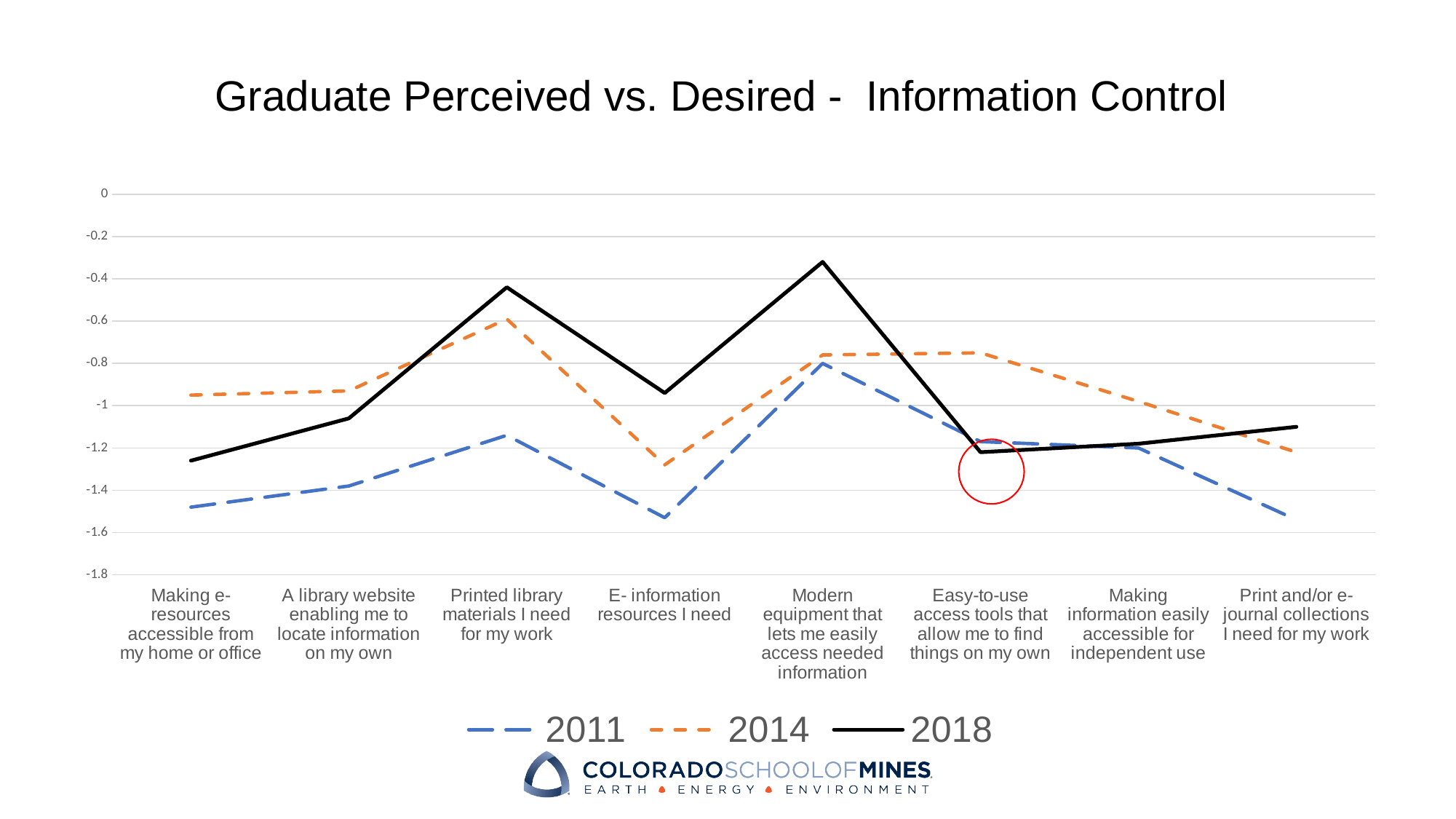
How many categories are plotted along the x axis? 8 For 'E- information resources I need', which series has the higher value, 2018 or 2014? 2018 Which series is drawn as a solid black line? 2018 Is the 2014 value for 'Printed library materials I need for my work' greater or less than -0.8? greater For the 2018 series, which category has the highest value? Modern equipment that lets me easily access needed information How many series does the legend list? 3 What kind of chart is shown on the slide? line chart Does the 2011 series rise or fall from 'Modern equipment that lets me easily access needed information' to 'Print and/or e-journal collections I need for my work'? fall Is the 2018 value for 'Modern equipment that lets me easily access needed information' greater or less than -0.4? greater For the 2014 series, which category has the highest value? Printed library materials I need for my work For 'Printed library materials I need for my work', which series has the higher value, 2018 or 2011? 2018 Is the 2011 value for 'Making e-resources accessible from my home or office' greater or less than -1.4? less